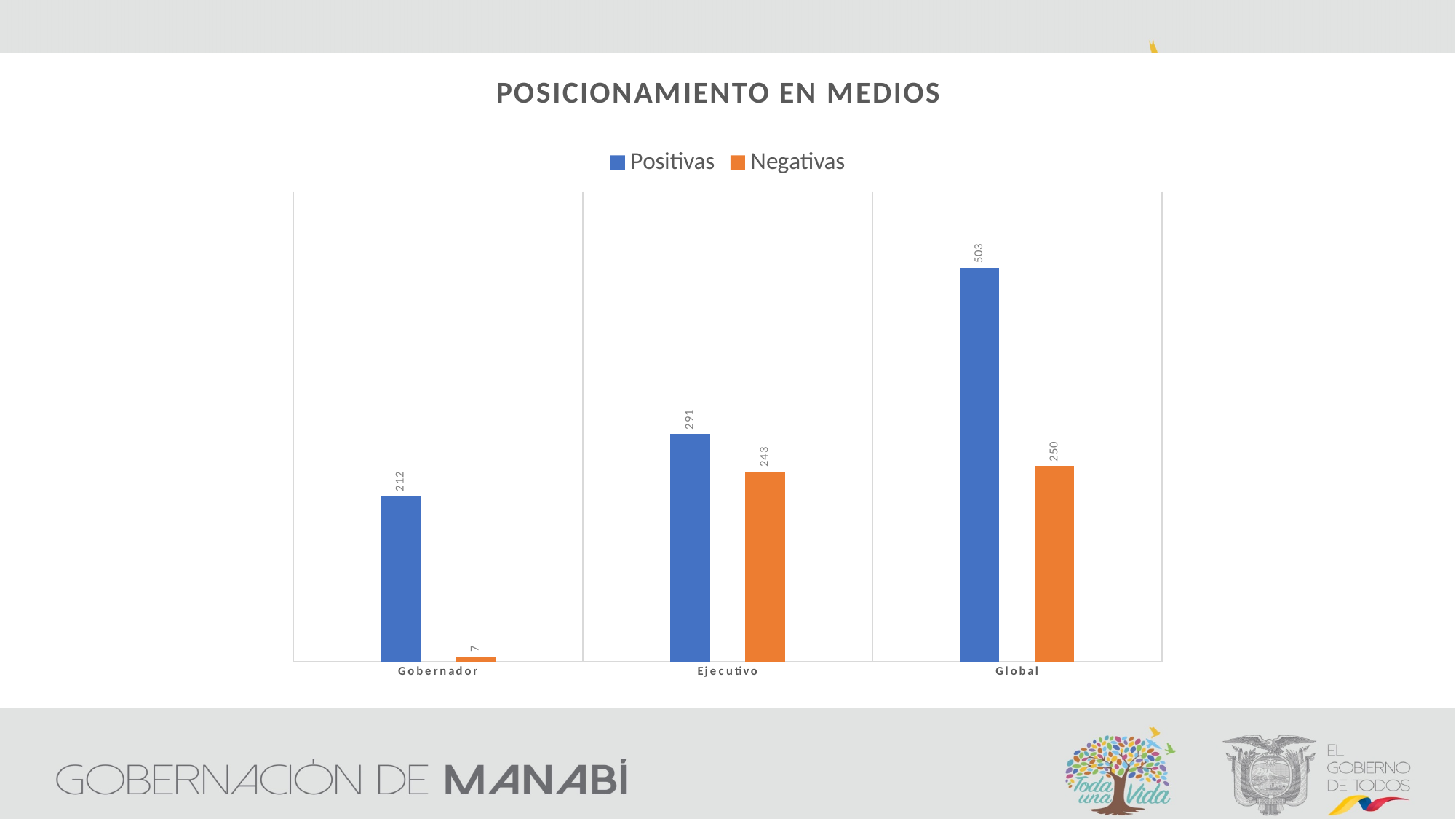
How many series does the legend list? 2 What is the Negativas value for Global? 250 Which category has the lowest Negativas value? Gobernador What is the Positivas value for Gobernador? 212 Which is larger for Global, Positivas or Negativas? Positivas What is the difference between the Positivas values for Global and Gobernador? 291 What type of chart is shown on the slide? Bar chart What is the Negativas value for Gobernador? 7 How many categories are shown on the x axis? 3 Which category has the highest Positivas value? Global What is the Positivas value for Ejecutivo? 291 What is the difference between the Positivas and Negativas values for Ejecutivo? 48